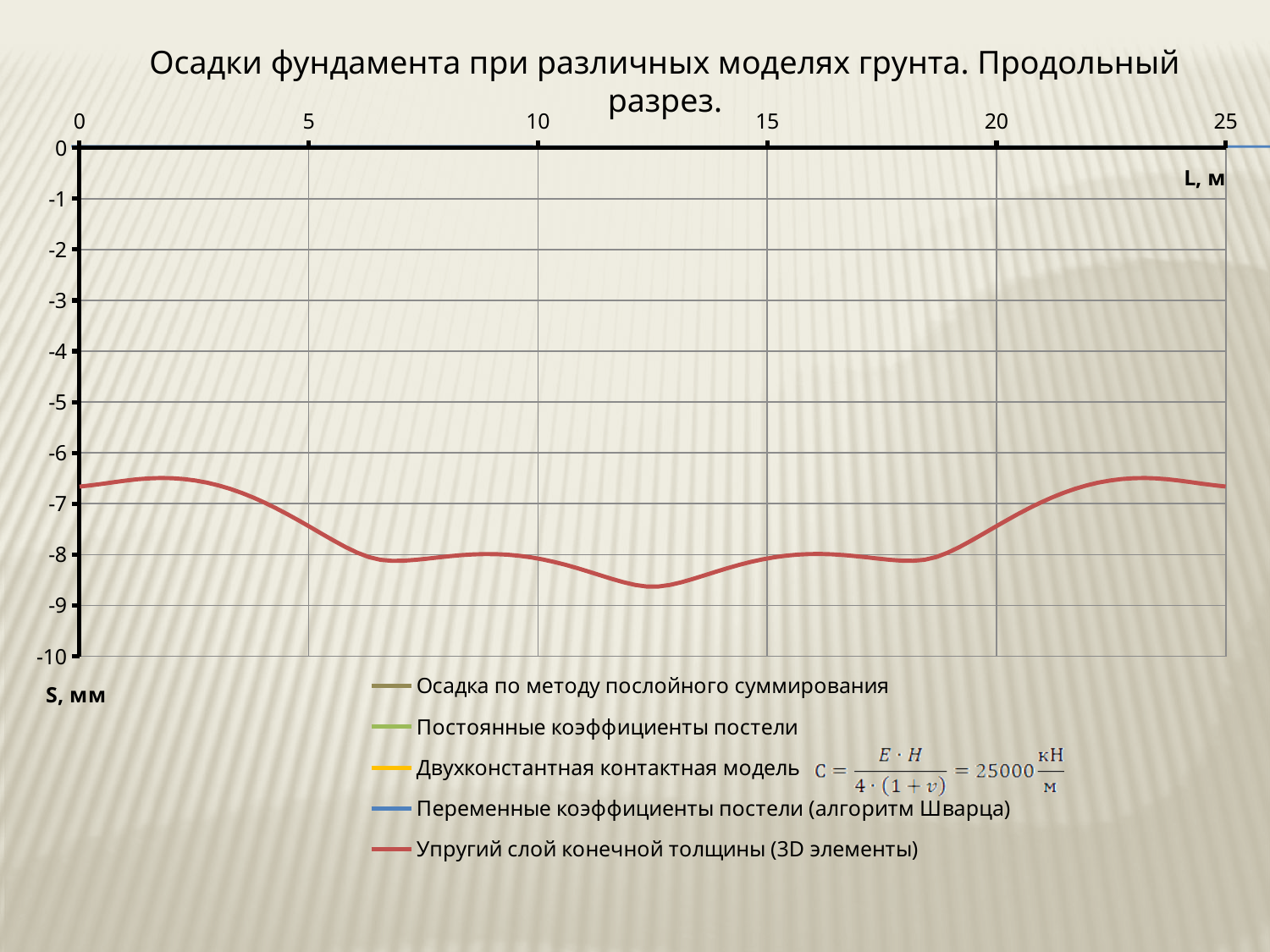
Is the value of the red line at L = 5 greater or less than -7? less How many series does the legend list? 5 Does the red line rise or fall as L goes from 12.5 to 25? rise Which legend entry corresponds to the red line that is plotted on the chart? Упругий слой конечной толщины (3D элементы) What kind of chart is shown on the slide? line chart Which is larger, the value of the red line at L = 0 or at L = 12.5? L = 0 Does the red line rise or fall as L goes from 0 to 12.5? fall Is the value of the red line at L = 12.5 greater or less than -8? less How many labeled tick marks are on the horizontal (L, м) axis? 6 Is the value of the red line at L = 0 greater or less than -7? greater What is the title of the chart? Осадки фундамента при различных моделях грунта. Продольный разрез.